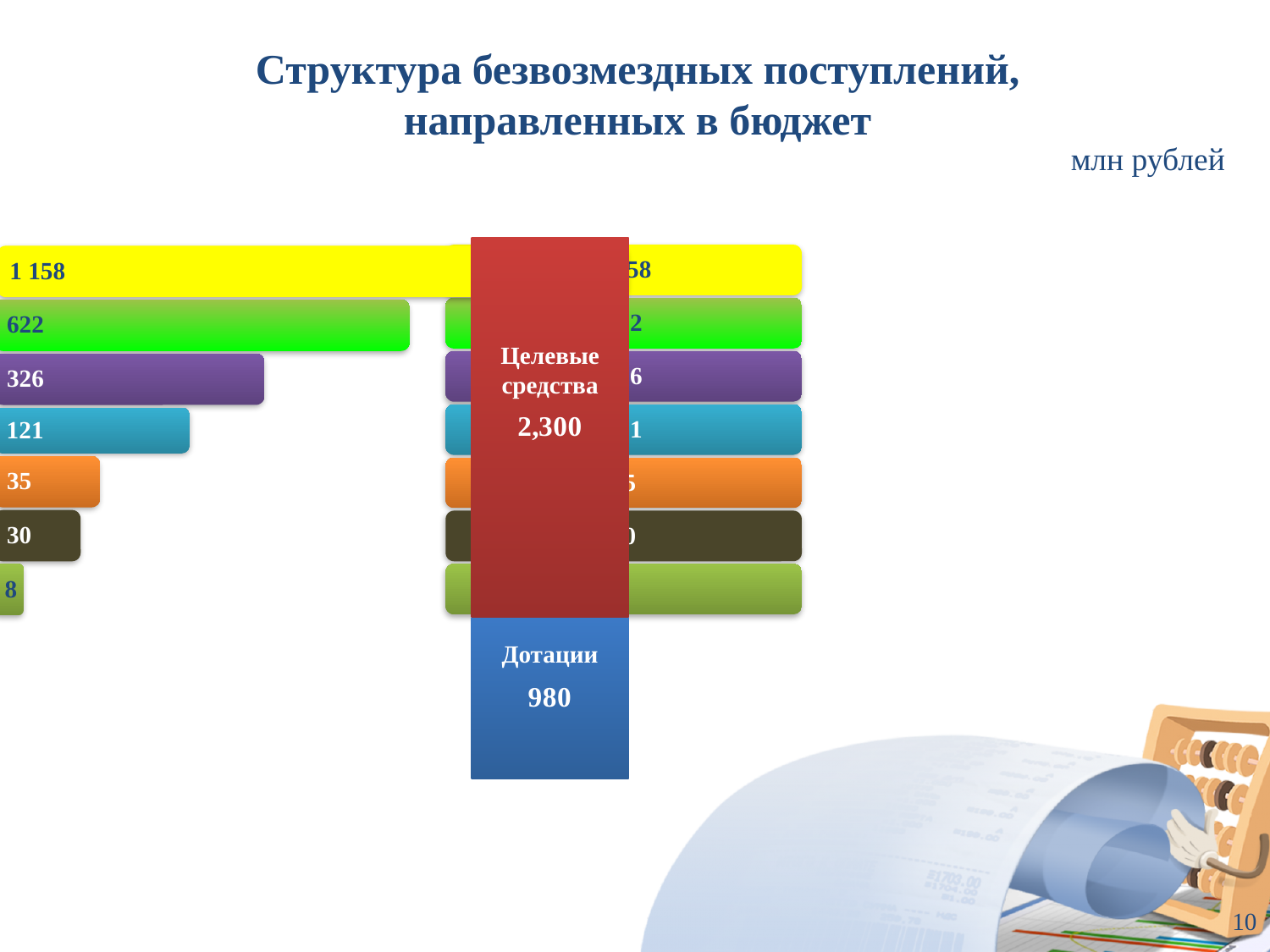
In what units are the values on the slide given? млн рублей What is the difference between the two largest horizontal bar values, 1 158 and 622? 536 What value is shown for Целевые средства? 2,300 What is the largest value shown on the horizontal bars? 1 158 Do the horizontal bar values increase or decrease from top to bottom? decrease What is the smallest value shown on the horizontal bars? 8 What is the total of the stacked column made up of Целевые средства and Дотации? 3,280 What value is shown for Дотации? 980 Which is larger, Целевые средства or Дотации? Целевые средства What is the difference between Целевые средства and Дотации? 1,320 What kind of chart is shown on the slide? bar chart